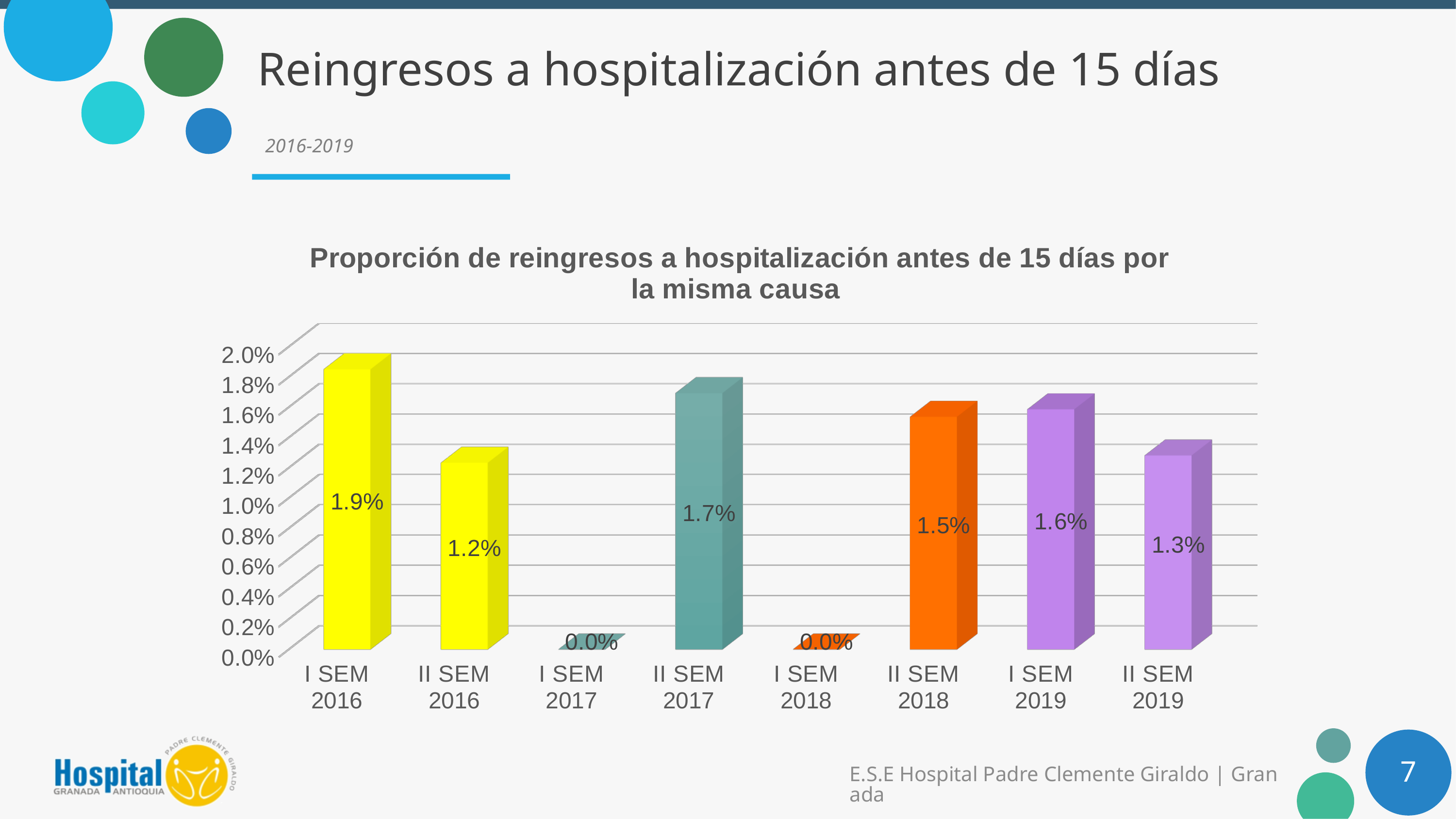
What kind of chart is shown? bar chart What is the title of the chart? Proporción de reingresos a hospitalización antes de 15 días por la misma causa What is the difference between the values for I SEM 2016 and II SEM 2016? 0.7% What is the value for II SEM 2017? 1.7% What is the difference between the values for I SEM 2019 and II SEM 2019? 0.3% How many categories are shown on the x axis? 8 What is the value for II SEM 2019? 1.3% Which is larger, the value for II SEM 2018 or the value for I SEM 2019? I SEM 2019 How many categories have a value of 0.0%? 2 Which category has the highest value? I SEM 2016 What is the value for I SEM 2018? 0.0% What is the value for I SEM 2016? 1.9%